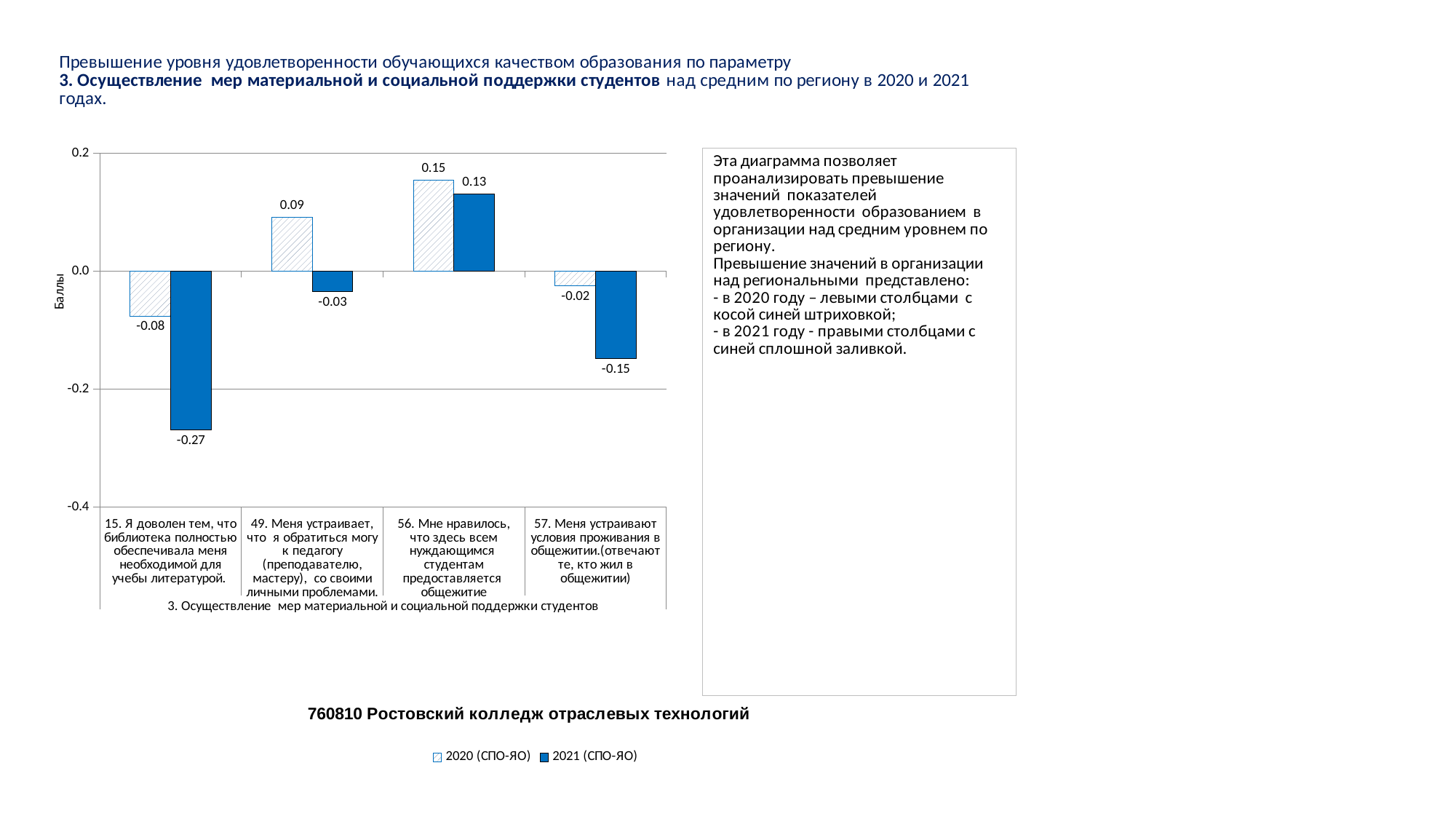
Which item has the lowest value in the 2021 (СПО-ЯО) series? 15. Я доволен тем, что библиотека полностью обеспечивала меня необходимой для учебы литературой. How many items (categories) are shown on the x axis of the chart? 4 How many series does the chart legend list? 2 What is the value for the 2021 (СПО-ЯО) series for item 49 (approaching a teacher with personal problems)? -0.03 What type of chart is shown on the slide? Bar chart What is the value for the 2020 (СПО-ЯО) series for item 56 (dormitory provided to students in need)? 0.15 For item 49, which series has the larger value, 2020 (СПО-ЯО) or 2021 (СПО-ЯО)? 2020 (СПО-ЯО) What is the value for the 2021 (СПО-ЯО) series for item 57 (dormitory living conditions)? -0.15 What is the value for the 2020 (СПО-ЯО) series for item 15 (library literature)? -0.08 Which item has the highest value in the 2020 (СПО-ЯО) series? 56. Мне нравилось, что здесь всем нуждающимся студентам предоставляется общежитие What is the value for the 2021 (СПО-ЯО) series for item 15 (library literature)? -0.27 What is the difference between the 2020 and 2021 values for item 15 (library literature)? 0.19